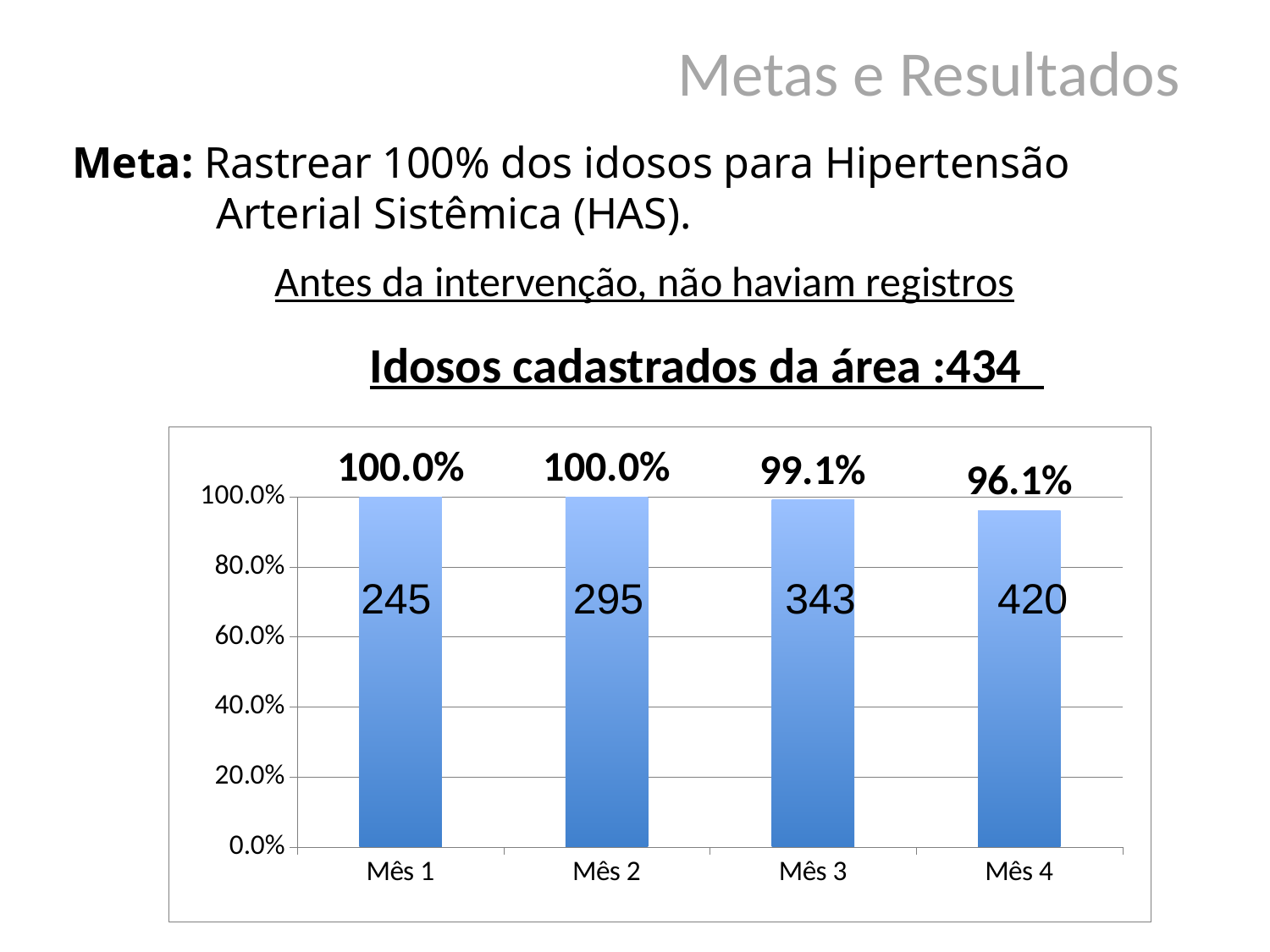
What percentage is shown for Mês 3? 99.1% How many months (categories) are shown on the x axis? 4 Do the percentage values rise or fall from Mês 2 to Mês 4? Fall What number is printed inside the bar for Mês 4? 420 What number is printed inside the bar for Mês 1? 245 What is the title shown above the chart? Idosos cadastrados da área :434 Which is larger, the percentage for Mês 3 or the percentage for Mês 4? Mês 3 What kind of chart is shown on the slide? Bar chart What percentage is shown for Mês 4? 96.1% Which month has the lowest percentage? Mês 4 What is the difference between the number printed for Mês 3 and the number printed for Mês 2? 48 What is the difference between the percentage for Mês 2 and the percentage for Mês 4? 3.9%